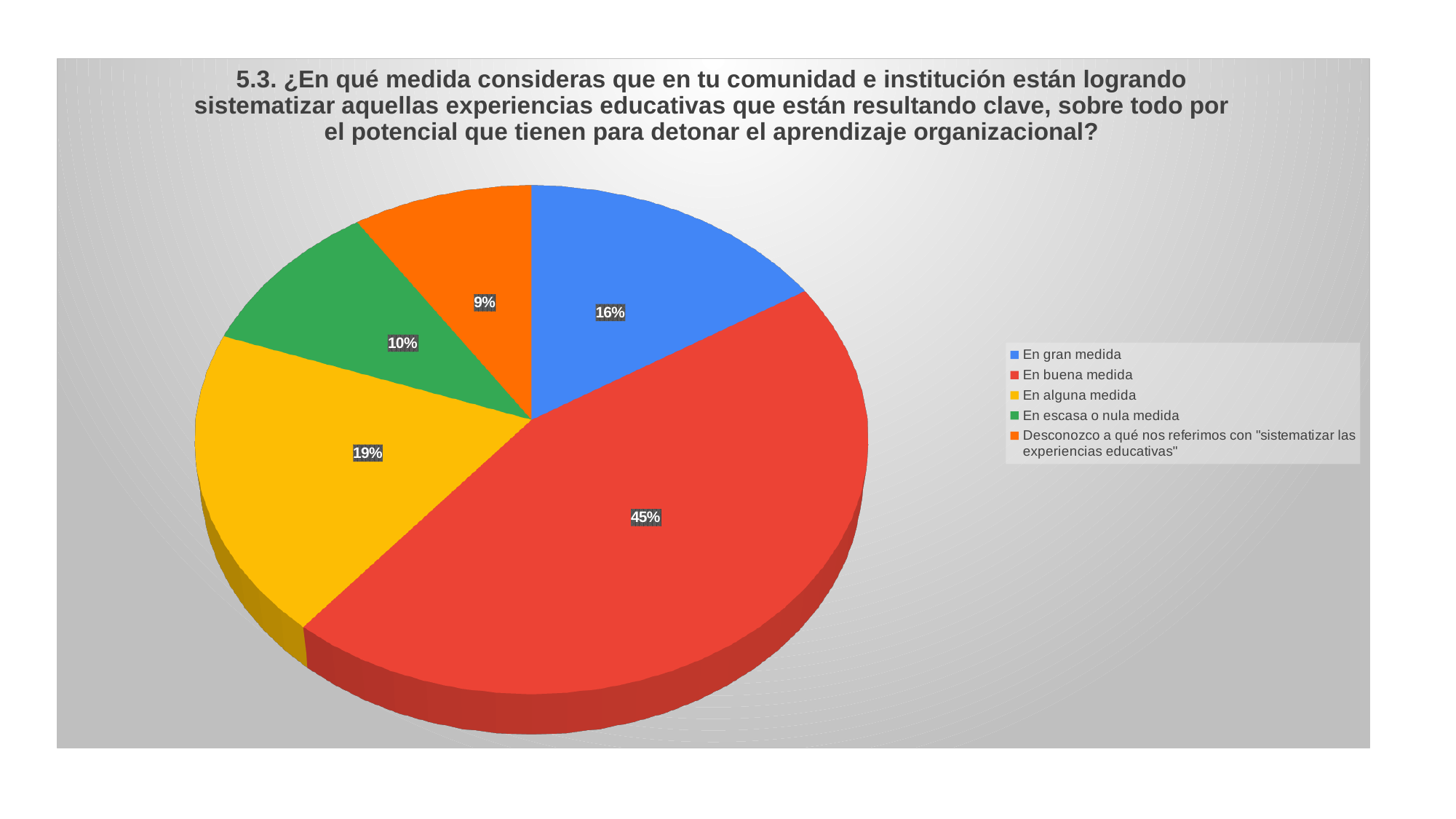
What is the difference in percentage points between "En buena medida" and "En alguna medida"? 26 What share of the pie does "En escasa o nula medida" represent? 10% Which category has the largest slice of the pie? En buena medida What share of the pie does "Desconozco a qué nos referimos con "sistematizar las experiencias educativas"" represent? 9% Which category has the smallest slice of the pie? Desconozco a qué nos referimos con "sistematizar las experiencias educativas" What share of the pie does "En alguna medida" represent? 19% How many categories does the legend list? 5 What colour is the slice for "En escasa o nula medida"? Green What kind of chart is shown on the slide? Pie chart Which is larger, the slice for "En gran medida" or the slice for "En alguna medida"? En alguna medida